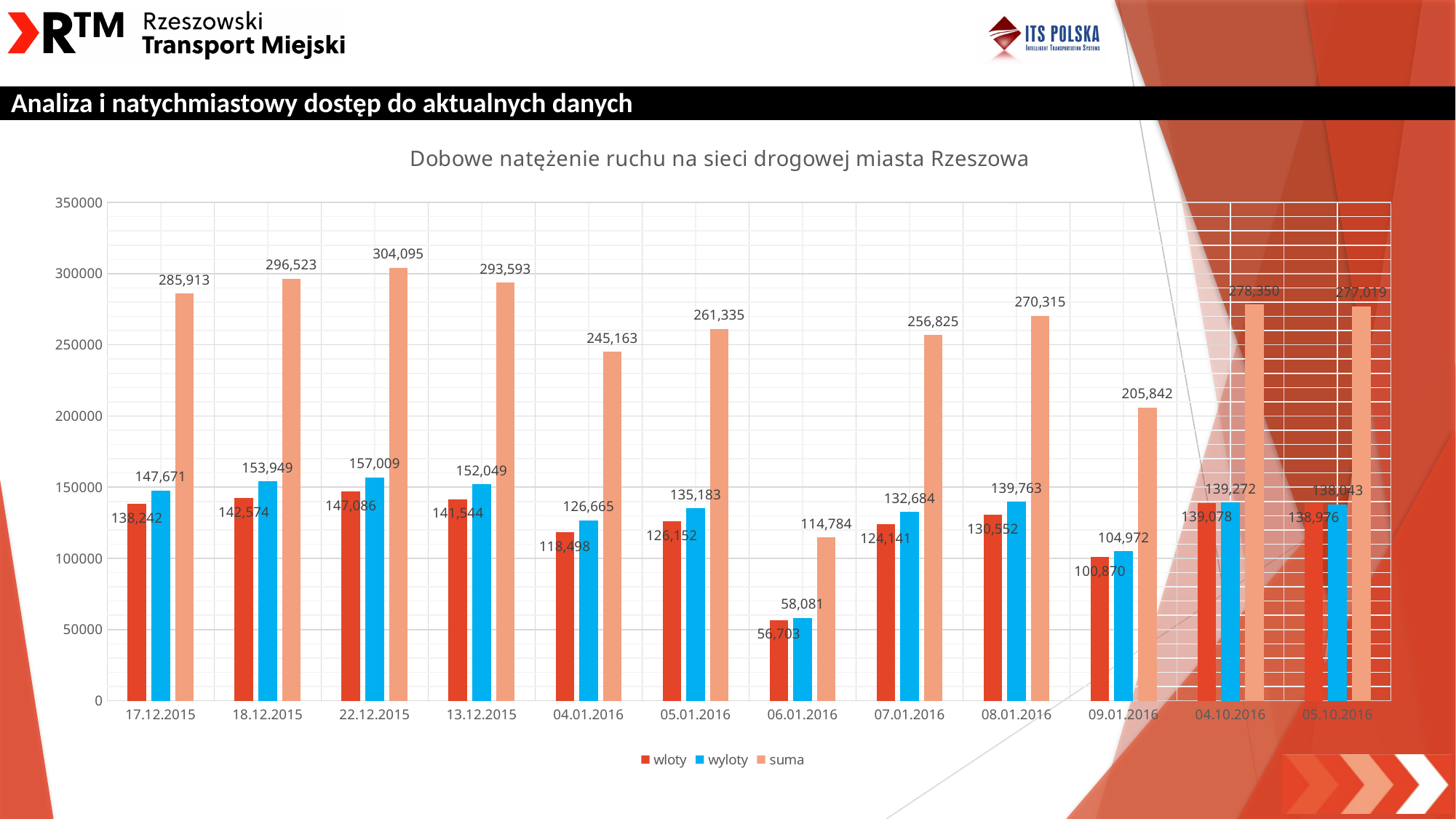
Which date has the lowest 'suma' value? 06.01.2016 How many dates are shown on the x axis? 12 How many series does the legend list? 3 What is the value of the 'suma' series for 22.12.2015? 304,095 What is the 'wloty' value for 06.01.2016? 56,703 What is the 'wyloty' value for 08.01.2016? 139,763 What type of chart is shown on the slide? bar chart Which is larger: the 'suma' value for 05.01.2016 or for 07.01.2016? 05.01.2016 What is the difference between the 'wyloty' and 'wloty' values for 22.12.2015? 9,923 Is the 'wloty' value for 09.01.2016 greater or less than 150000? less What is the difference between the 'suma' values for 18.12.2015 and 17.12.2015? 10,610 Which date has the highest 'suma' value? 22.12.2015